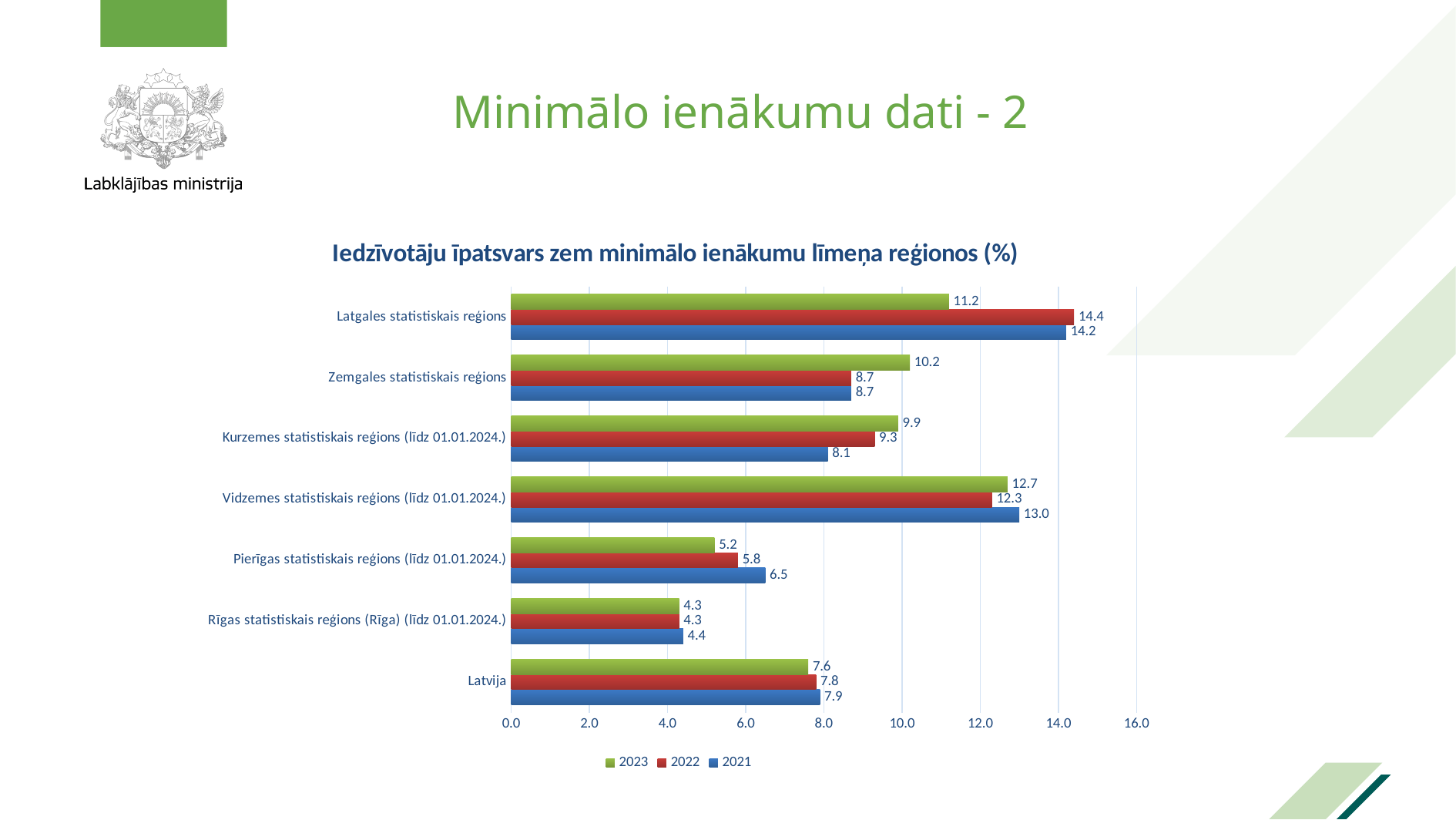
What is the title of the chart? Iedzīvotāju īpatsvars zem minimālo ienākumu līmeņa reģionos (%) Which colour represents the 2021 series in the legend? Blue Which category has the lowest 2023 value? Rīgas statistiskais reģions (Rīga) (līdz 01.01.2024.) What is the difference between the 2022 and 2023 values for Latgales statistiskais reģions? 3.2 What is the 2021 value for Vidzemes statistiskais reģions (līdz 01.01.2024.)? 13.0 Which is larger for Kurzemes statistiskais reģions (līdz 01.01.2024.): the 2021 value or the 2023 value? 2023 What kind of chart is shown on the slide? Bar chart How many series does the legend list? 3 What is the 2023 value for Latgales statistiskais reģions? 11.2 Which region has the highest 2022 value? Latgales statistiskais reģions How many categories are shown on the chart? 7 What is the 2022 value for Latvija? 7.8